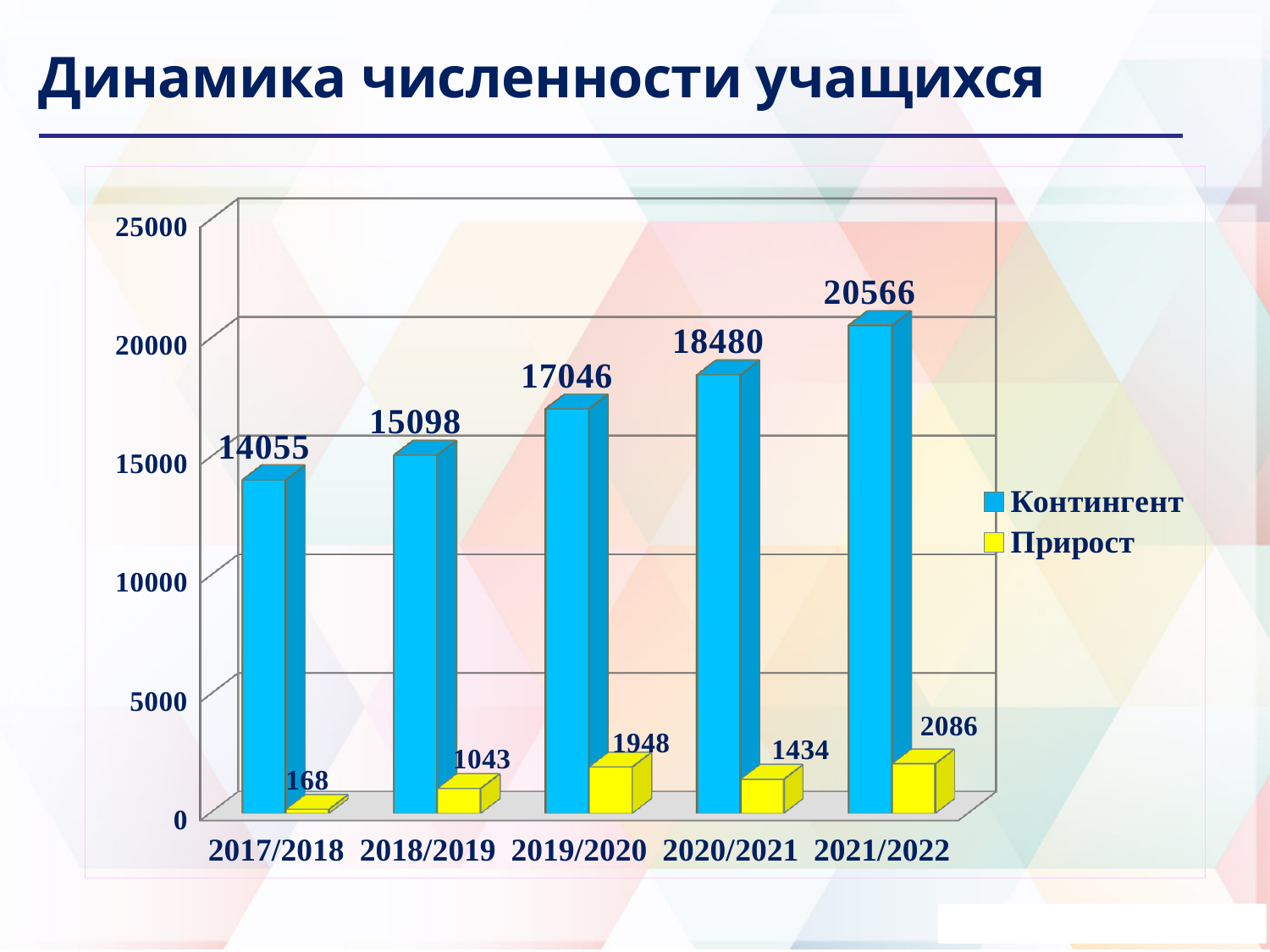
Which is larger, the Прирост value for 2019/2020 or for 2020/2021? 2019/2020 What is the Контингент value for 2021/2022? 20566 Do the Контингент values rise or fall from 2017/2018 to 2021/2022? rise What is the Прирост value for 2018/2019? 1043 How many academic years are shown on the x axis? 5 What kind of chart is shown on the slide? bar chart What is the difference between the Контингент values for 2020/2021 and 2019/2020? 1434 Which year has the highest Прирост value? 2021/2022 Is the Контингент value for 2018/2019 greater or less than 15000? greater Which year has the lowest Контингент value? 2017/2018 What is the Контингент value for 2019/2020? 17046 How many series does the legend list? 2